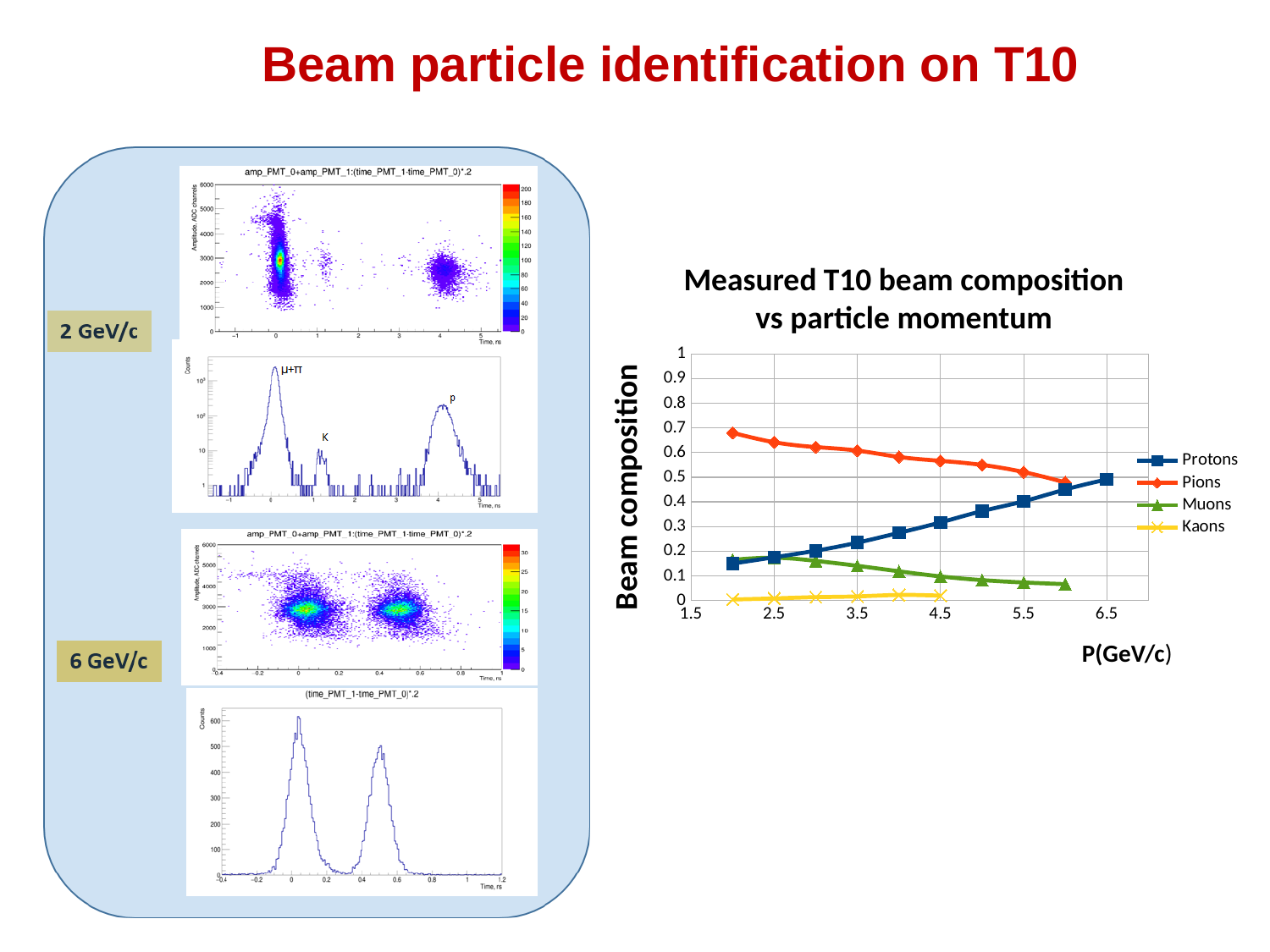
How many series does the legend of the "Measured T10 beam composition vs particle momentum" chart list? 4 In the "Measured T10 beam composition vs particle momentum" chart, do the Protons values rise or fall as momentum increases? rise What is the label of the vertical axis of the "Measured T10 beam composition vs particle momentum" chart? Beam composition In the "Measured T10 beam composition vs particle momentum" chart, which is larger at 6 GeV/c: Protons or Muons? Protons In the "Measured T10 beam composition vs particle momentum" chart, do the Pions values rise or fall as momentum increases? fall In the "Measured T10 beam composition vs particle momentum" chart, is the Pions value at 2 GeV/c greater or less than 0.6? greater What kind of chart is "Measured T10 beam composition vs particle momentum"? line chart In the "Measured T10 beam composition vs particle momentum" chart, is the Muons value at 6 GeV/c greater or less than 0.1? less In the "Measured T10 beam composition vs particle momentum" chart, which is larger at 3 GeV/c: Pions or Protons? Pions In the "Measured T10 beam composition vs particle momentum" chart, which series has the highest value at 2 GeV/c? Pions In the "Measured T10 beam composition vs particle momentum" chart, which series has the lowest value at 2 GeV/c? Kaons